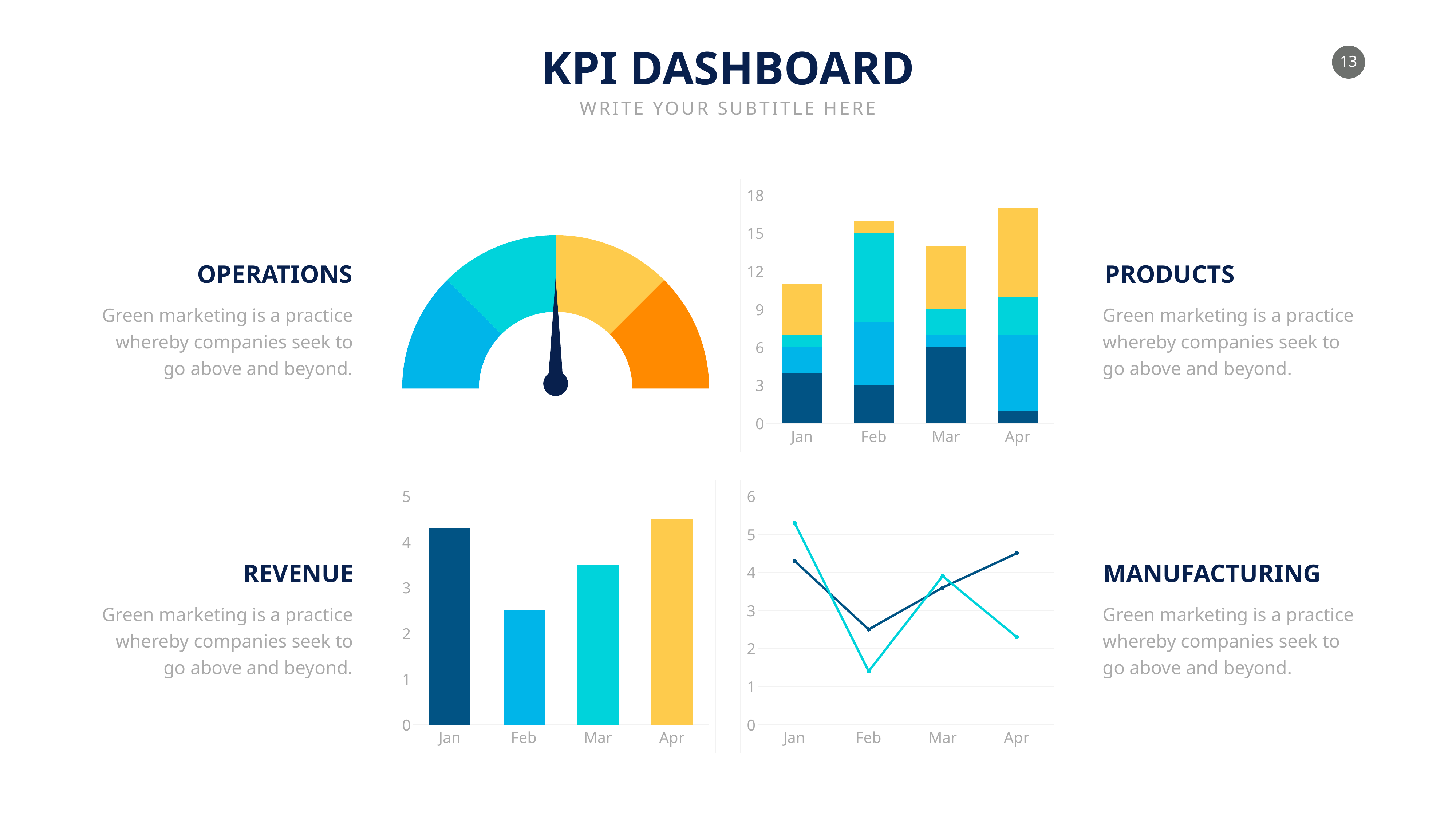
In the bottom-left REVENUE bar chart, which month has the highest bar? Apr In the top-right stacked bar chart next to PRODUCTS, is the total for Jan greater or less than 12? less How many months are shown on the x axis of the bottom-left REVENUE bar chart? 4 How many lines are plotted in the bottom-right MANUFACTURING line chart? 2 In the top-right stacked bar chart next to PRODUCTS, which month has the tallest stacked bar? Apr In the top-right stacked bar chart next to PRODUCTS, which month has the shortest stacked bar? Jan What kind of chart is the bottom-right chart next to the MANUFACTURING heading? line chart What kind of chart is the bottom-left chart next to the REVENUE heading? bar chart In the bottom-left REVENUE bar chart, is the value for Jan greater or less than 4? greater In the bottom-right MANUFACTURING line chart, is the value of the light cyan line for Feb greater or less than 2? less In the bottom-left REVENUE bar chart, which month has the lowest bar? Feb